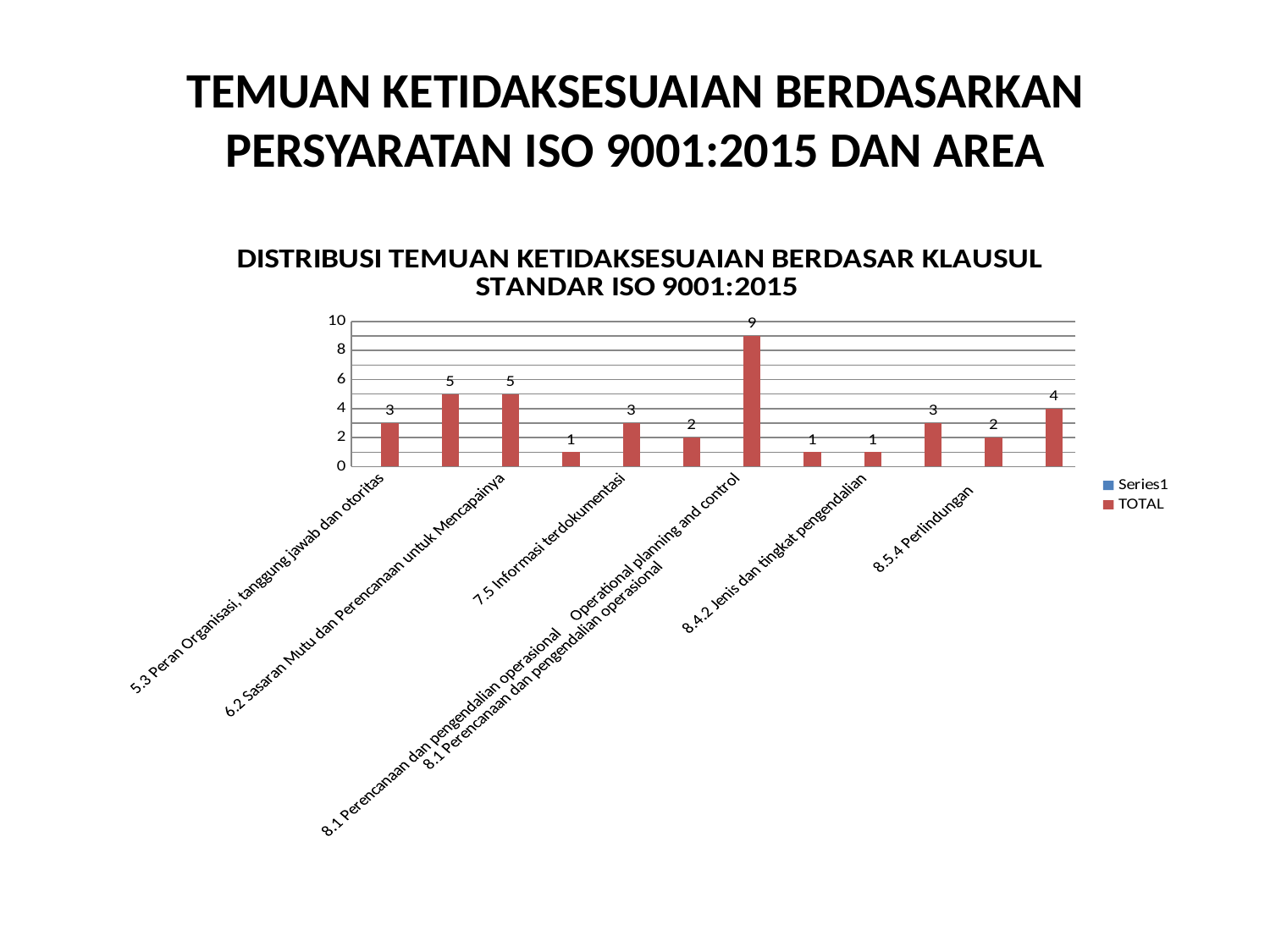
What is the value for 5.3 Peran Organisasi, tanggung jawab dan otoritas? 3 What is the value for 7.5 Informasi terdokumentasi? 3 What is the title of the chart? DISTRIBUSI TEMUAN KETIDAKSESUAIAN BERDASAR KLAUSUL STANDAR ISO 9001:2015 What is the value for 6.2 Sasaran Mutu dan Perencanaan untuk Mencapainya? 5 What is the value for 8.4.2 Jenis dan tingkat pengendalian? 1 What is the difference between the values for 6.2 Sasaran Mutu dan Perencanaan untuk Mencapainya and 8.5.4 Perlindungan? 3 What is the value for 8.5.4 Perlindungan? 2 Which has a larger value, 6.2 Sasaran Mutu dan Perencanaan untuk Mencapainya or 7.5 Informasi terdokumentasi? 6.2 Sasaran Mutu dan Perencanaan untuk Mencapainya How many bars are plotted in the chart? 12 How many entries does the legend list? 2 What is the highest value shown by any bar in the chart? 9 What type of chart is shown on the slide? bar chart